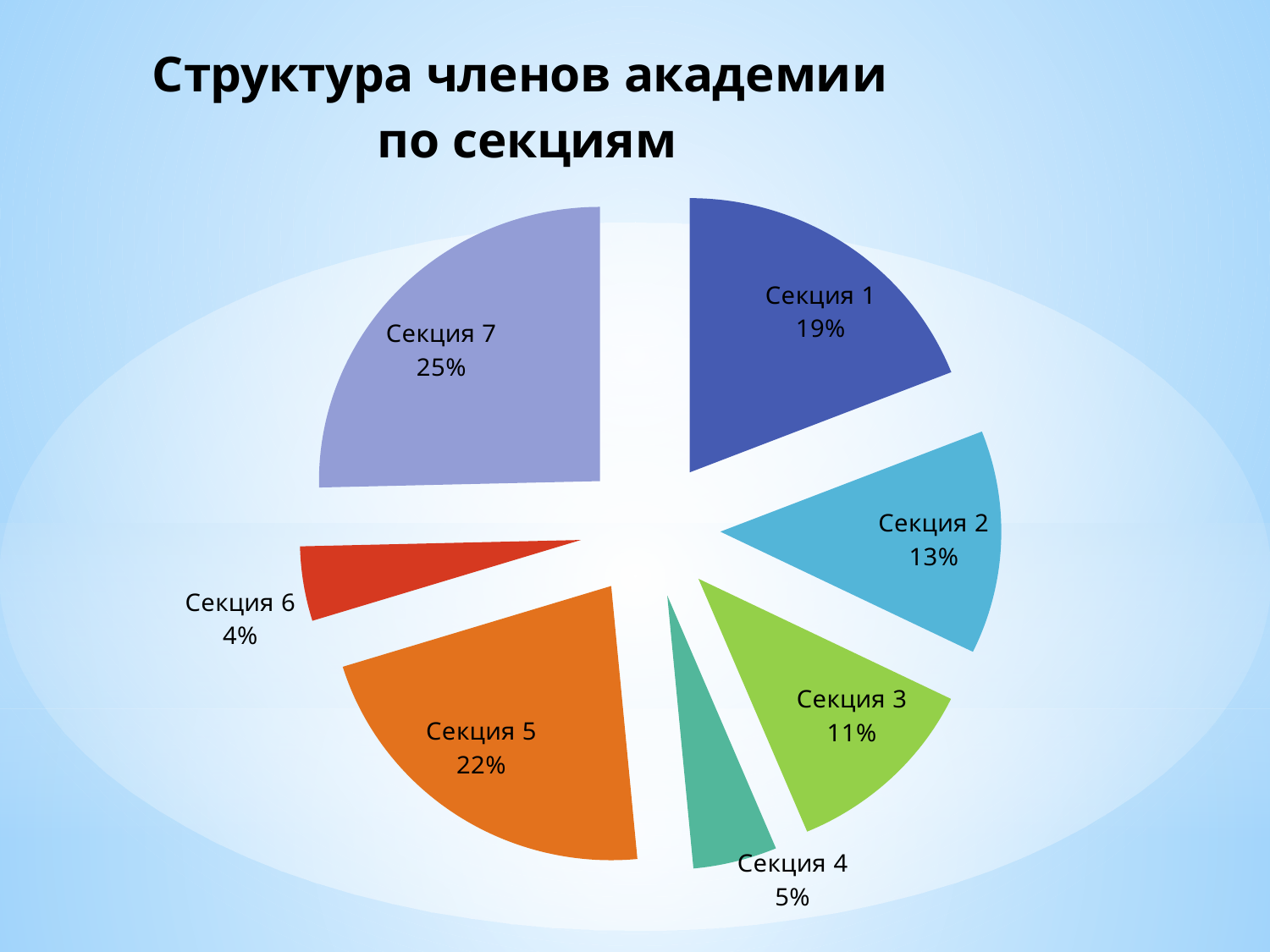
Which is larger, the share of Секция 3 or the share of Секция 2? Секция 2 What is the value shown for Секция 4? 5% How many sections are shown in the pie chart? 7 What is the combined share of Секция 4 and Секция 6? 9% What share of the pie does Секция 7 have? 25% What is the difference between the shares of Секция 5 and Секция 2? 9% What kind of chart is shown on the slide? Pie chart What colour is the slice for Секция 5? Orange Which section has the largest slice of the pie? Секция 7 Which section has the smallest slice of the pie? Секция 6 What is the title of the chart? Структура членов академии по секциям What is the value shown for Секция 1? 19%